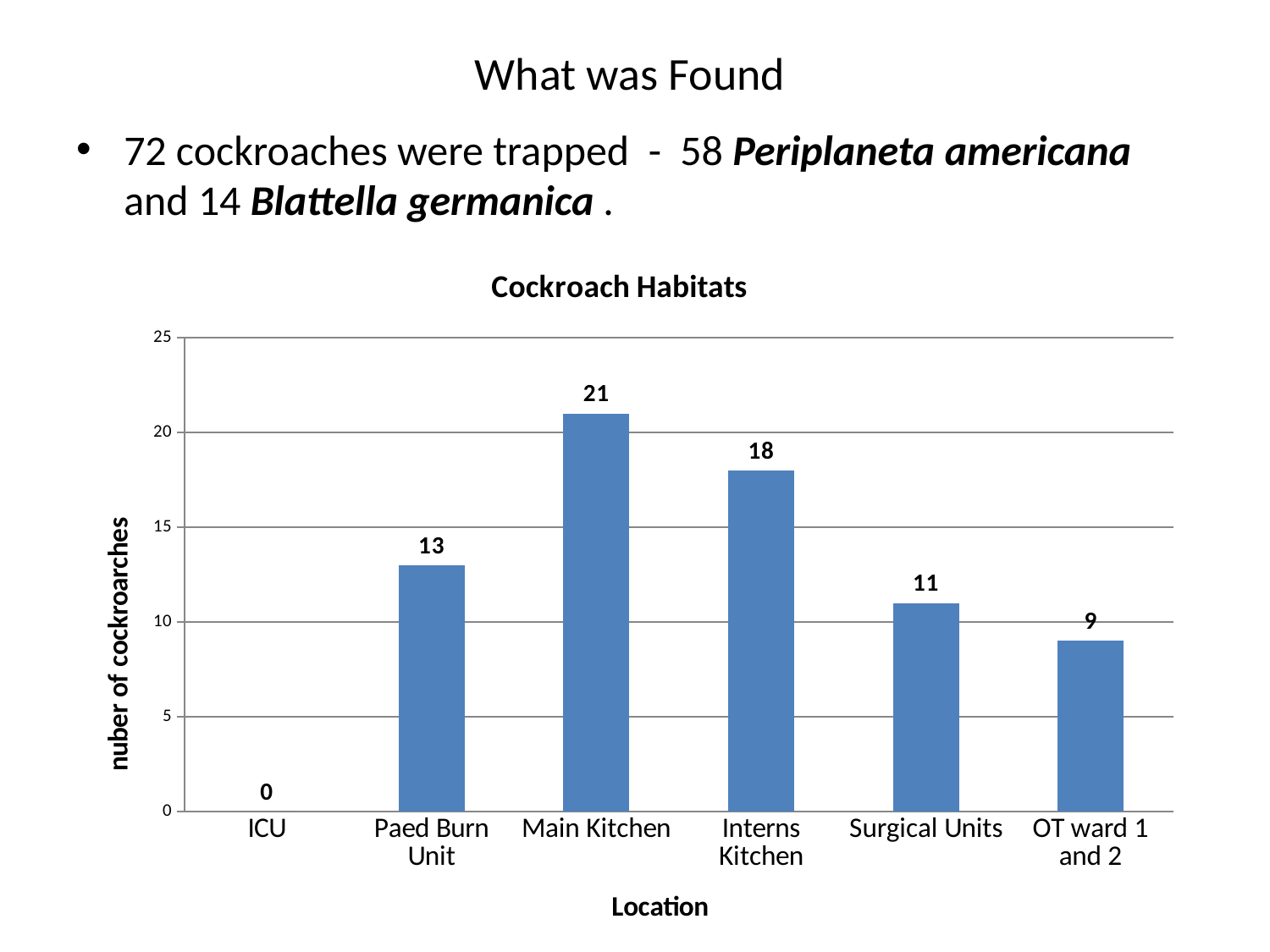
What is the number of cockroaches found in OT ward 1 and 2? 9 Which has more cockroaches, Surgical Units or the Paed Burn Unit? Paed Burn Unit What is the label of the x axis of the chart? Location Which location has the lowest number of cockroaches? ICU What is the number of cockroaches found in the Interns Kitchen? 18 What is the difference between the number of cockroaches in the Main Kitchen and the Interns Kitchen? 3 How many locations are shown on the x axis of the chart? 6 Which location has the highest number of cockroaches? Main Kitchen What is the number of cockroaches found in the Paed Burn Unit? 13 What kind of chart is shown on the slide? Bar chart What is the title of the chart? Cockroach Habitats What is the number of cockroaches found in the Main Kitchen? 21